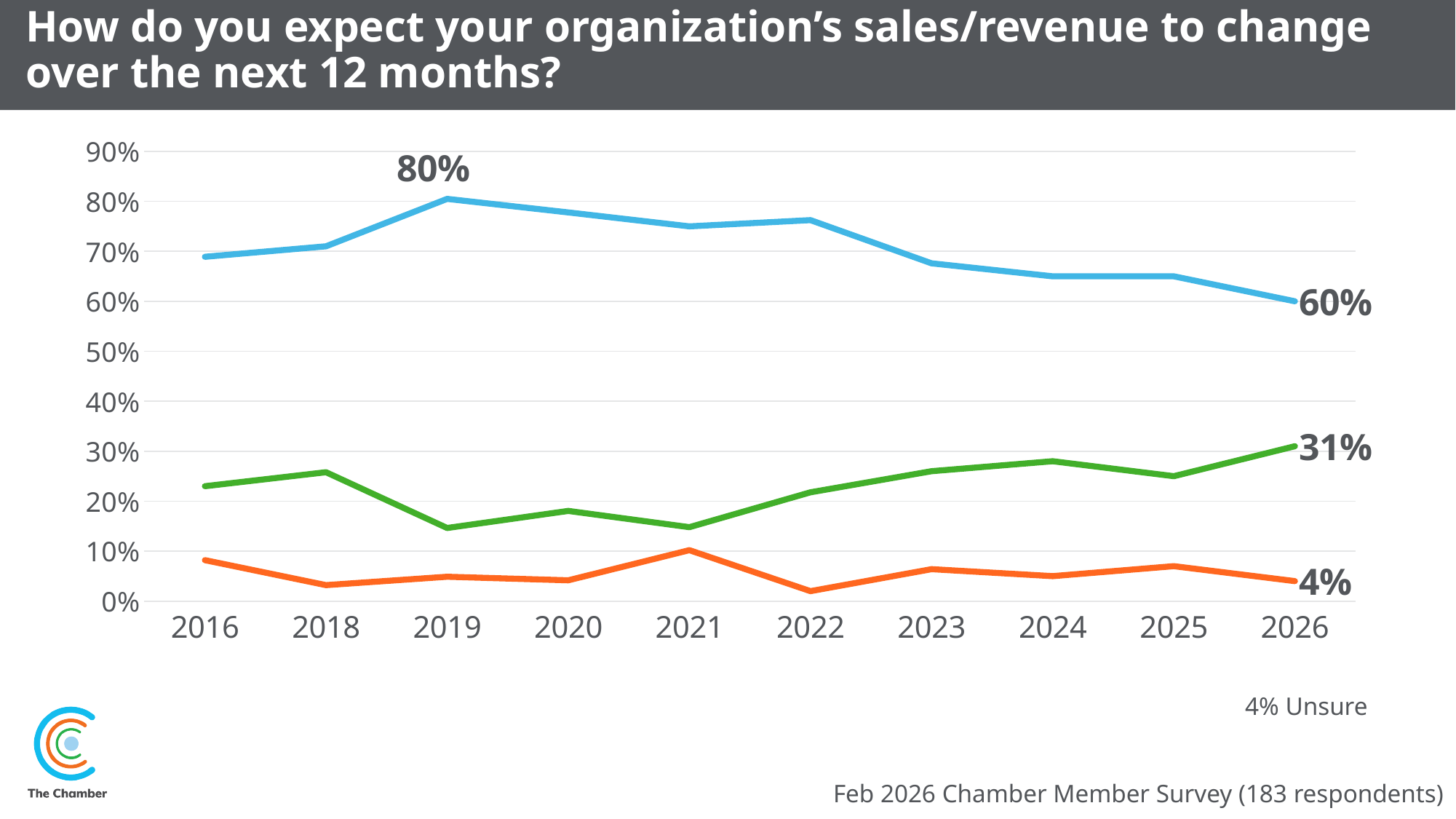
In 2026, which line has the larger value, the blue line or the green line? the blue line Is the value of the green line in 2019 greater or less than 20%? less Is the value of the blue line in 2016 greater or less than 60%? greater By how many percentage points did the blue line fall from its 2019 value to its 2026 value? 20 percentage points How many years are plotted along the x axis? 10 What is the value of the green line in 2026? 31% What is the value of the blue line in 2026? 60% What kind of chart is shown on the slide? line chart Does the blue line rise or fall between 2022 and 2026? fall What is the value of the orange line in 2026? 4% What is the value of the blue line in 2019? 80% In which year does the blue line reach its highest value? 2019